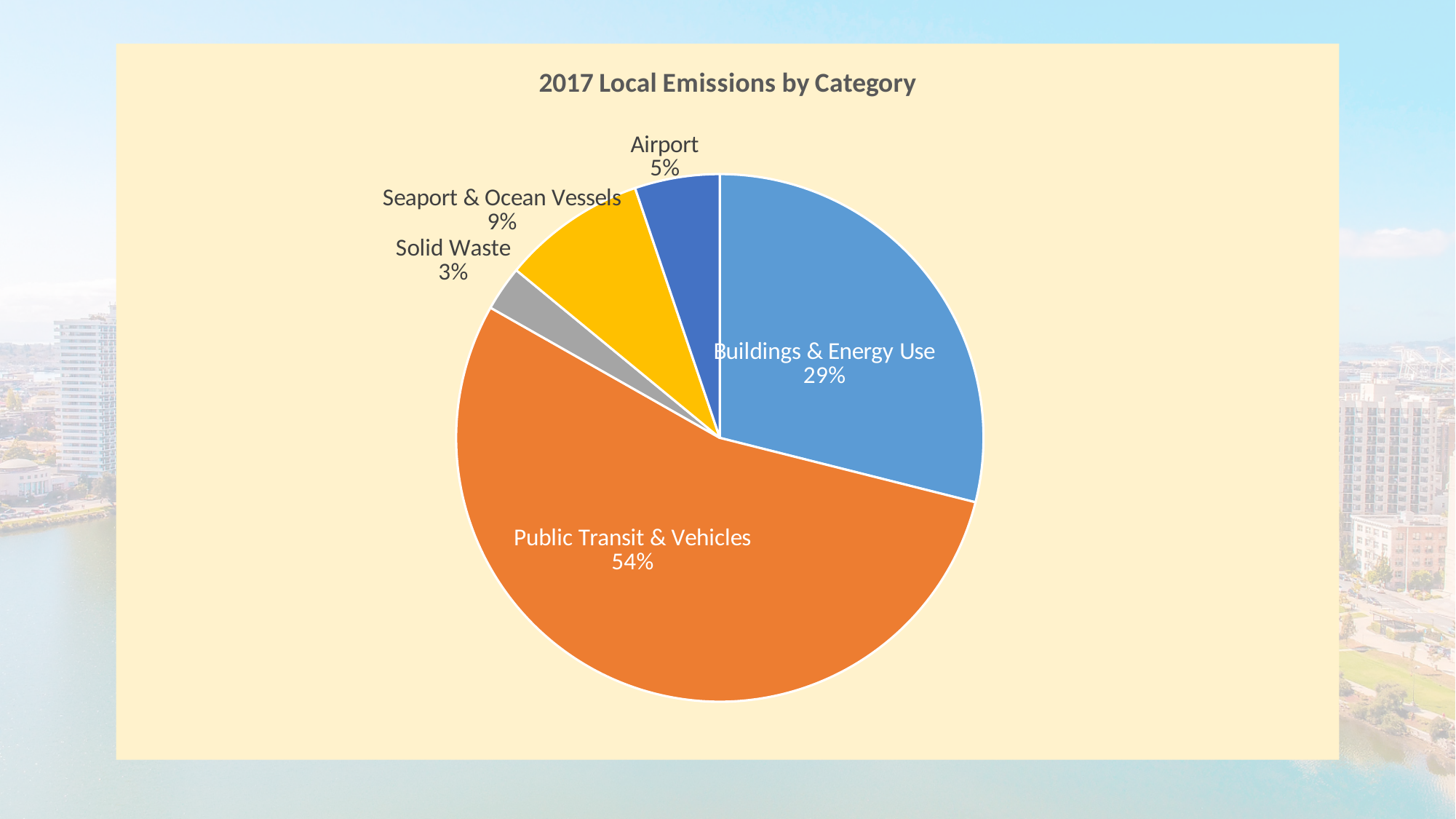
What is the title of the chart? 2017 Local Emissions by Category Which category has the smallest share of emissions? Solid Waste What is the difference in percentage points between Public Transit & Vehicles and Buildings & Energy Use? 25 What share of emissions comes from Public Transit & Vehicles? 54% Which has a larger share, Seaport & Ocean Vessels or Airport? Seaport & Ocean Vessels What kind of chart is shown on the slide? pie chart What share of emissions comes from Buildings & Energy Use? 29% How many categories are shown in the pie chart? 5 What percentage is shown for Seaport & Ocean Vessels? 9% What percentage is shown for Solid Waste? 3% Which category has the largest share of emissions? Public Transit & Vehicles What percentage is shown for Airport? 5%